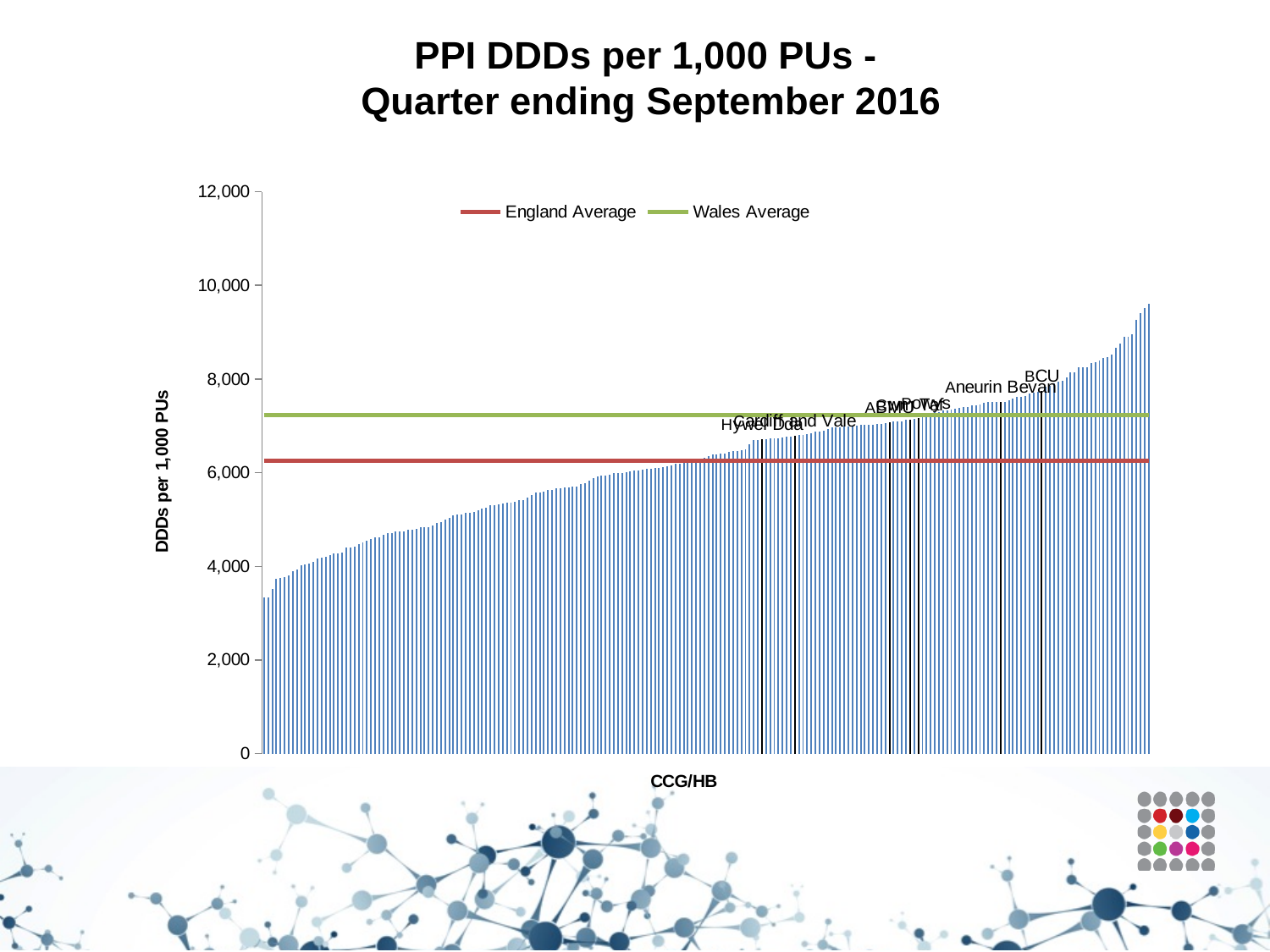
What kind of chart is shown on the slide? bar chart Which is higher, the Wales Average line or the England Average line? Wales Average Do the bar values rise or fall from left to right along the x axis? rise Is the Wales Average value greater or less than 8,000? less How many series does the legend list? 2 Is the value of the shortest bar greater or less than 4,000? less Which has the higher value, BCU or Hywel Dda? BCU Is the value of the tallest bar greater or less than 10,000? less What is the label on the vertical axis? DDDs per 1,000 PUs Which two series are listed in the legend? England Average and Wales Average